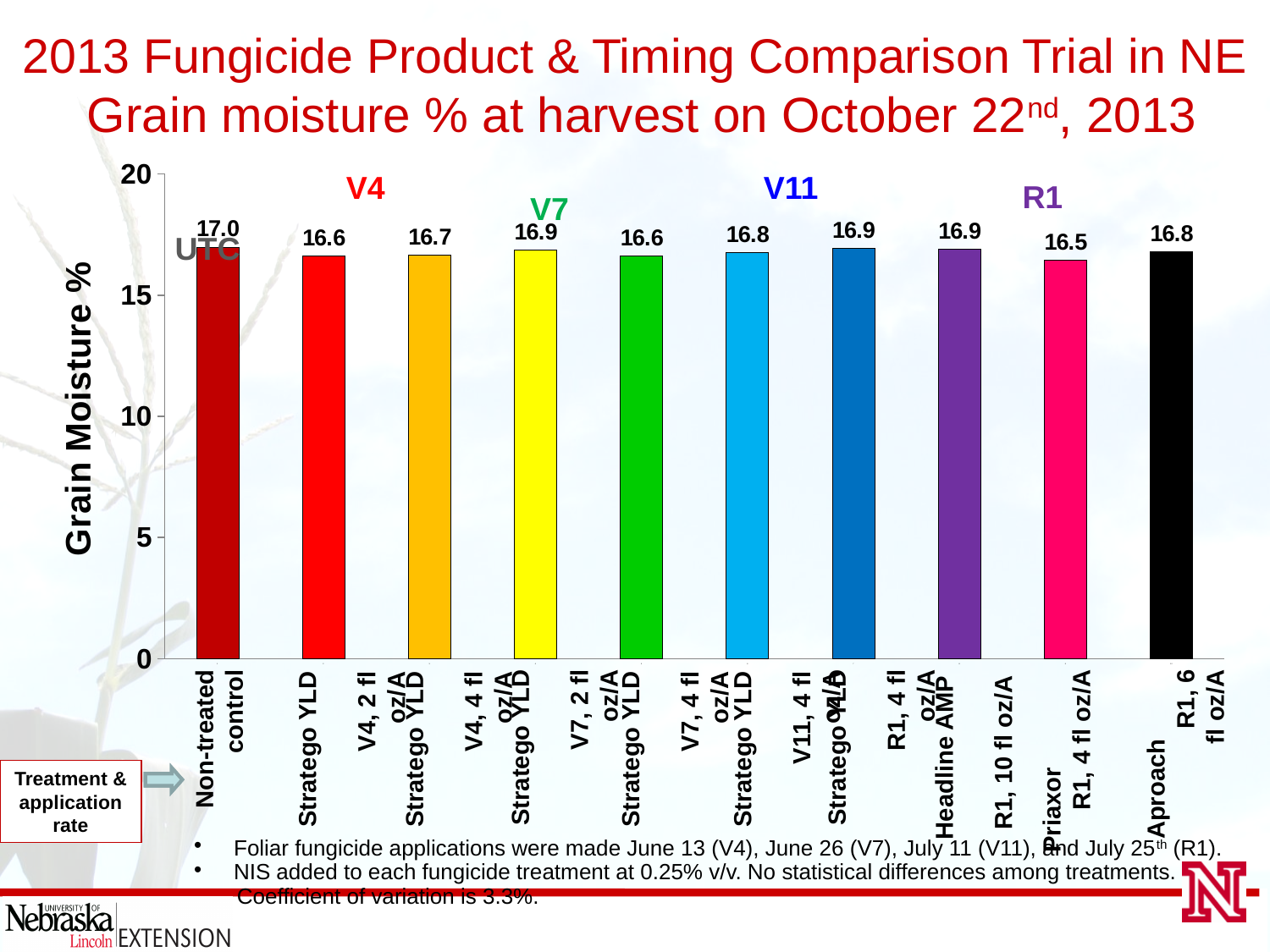
Which has a higher grain moisture %: Stratego YLD at V4, 2 fl oz/A or Stratego YLD at V4, 4 fl oz/A? Stratego YLD at V4, 4 fl oz/A What is the grain moisture % for the Non-treated control? 17.0 What is the difference in grain moisture % between the Non-treated control and Priaxor at R1, 4 fl oz/A? 0.5 What is the grain moisture % for Priaxor at R1, 4 fl oz/A? 16.5 What type of chart is shown on the slide? Bar chart What is the label of the vertical axis of the chart? Grain Moisture % What is the grain moisture % for Headline AMP at R1, 10 fl oz/A? 16.9 Which treatment has the lowest grain moisture %? Priaxor, R1, 4 fl oz/A How many treatment bars are shown in the chart? 10 Is the grain moisture % for Stratego YLD at V11, 4 fl oz/A greater or less than 15? greater Which treatment has the highest grain moisture %? Non-treated control What is the grain moisture % for Aproach at R1, 6 fl oz/A? 16.8